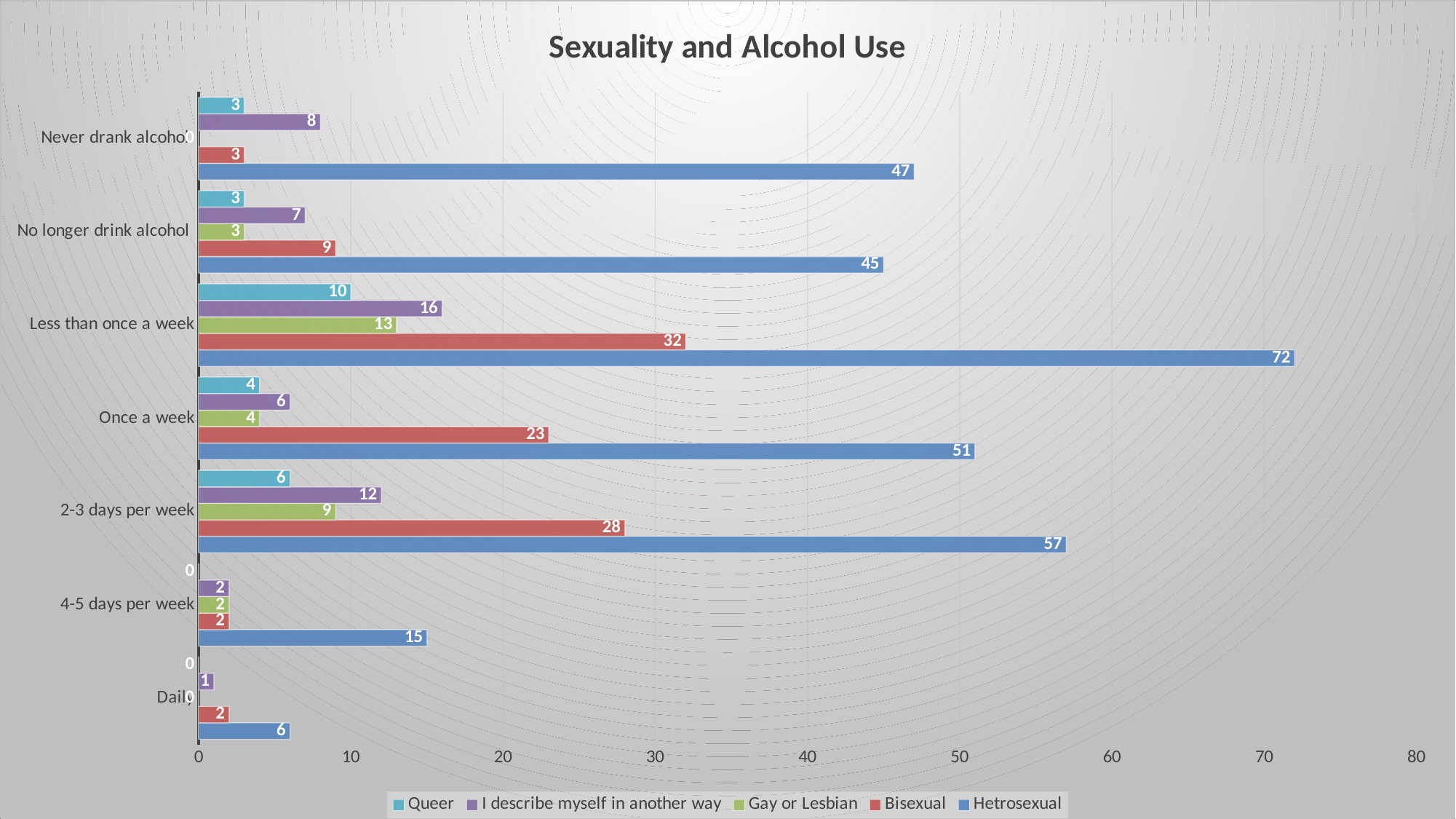
What is the value for I describe myself in another way for Never drank alcohol? 8 Which is larger for Once a week: the Bisexual value or the Queer value? Bisexual Which category has the lowest Hetrosexual value? Daily What is the difference between the Hetrosexual values for 2-3 days per week and Once a week? 6 What is the Hetrosexual value for Less than once a week? 72 Which category has the highest Hetrosexual value? Less than once a week How many categories are shown on the vertical axis? 7 How many series does the legend list? 5 What kind of chart is shown on the slide? Bar chart What is the title of the chart? Sexuality and Alcohol Use What is the Gay or Lesbian value for Less than once a week? 13 What is the Bisexual value for 2-3 days per week? 28